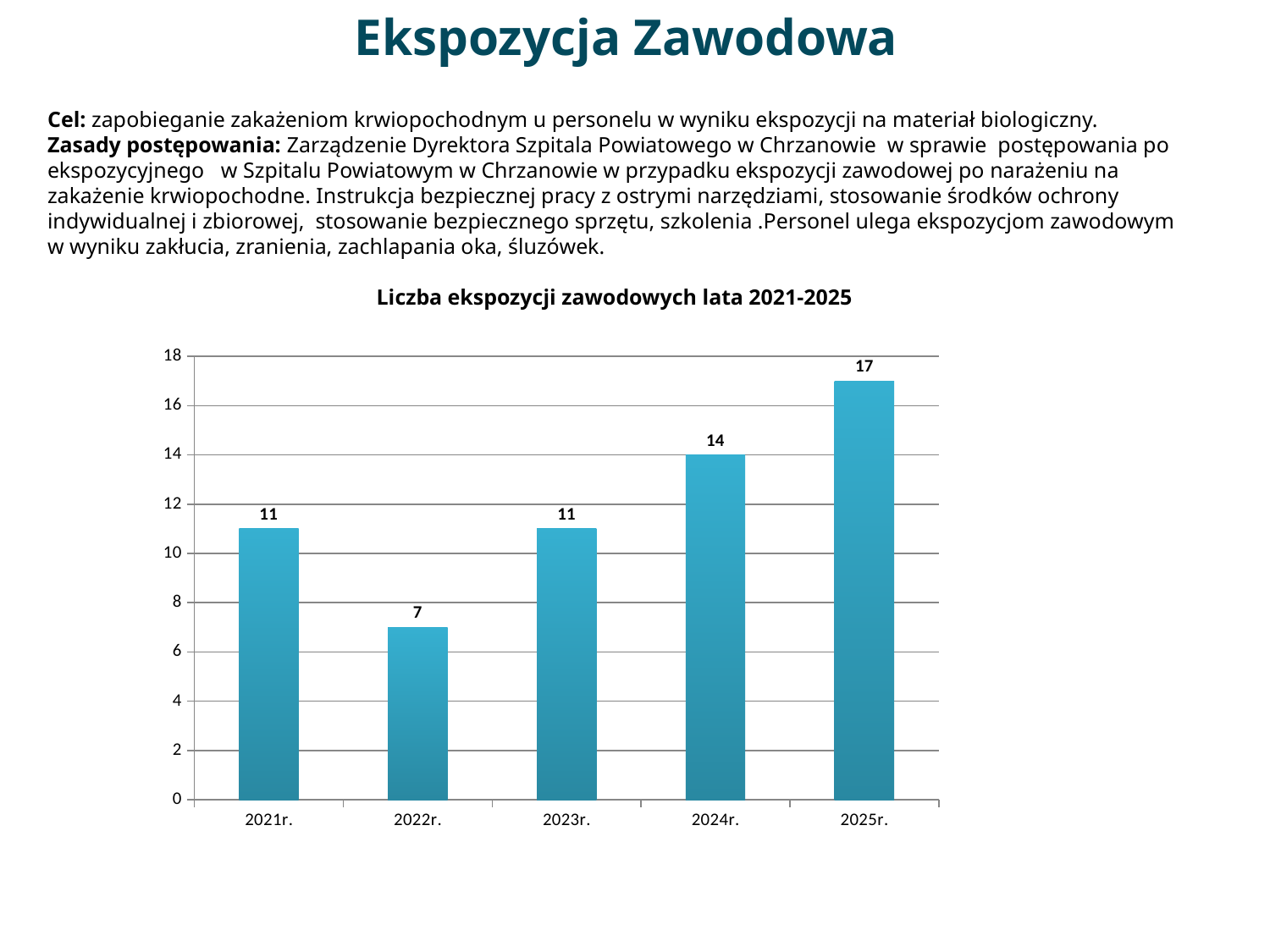
What is the difference between the values for 2024r. and 2023r.? 3 Which year has the highest value? 2025r. What is the value for 2024r.? 14 What is the value for 2022r.? 7 Which is larger, the value for 2021r. or the value for 2024r.? 2024r. What is the value for 2025r.? 17 How many years are shown on the chart? 5 What is the difference between the values for 2025r. and 2022r.? 10 What is the title of the chart? Liczba ekspozycji zawodowych lata 2021-2025 What is the value for 2021r.? 11 What kind of chart is shown on the slide? bar chart Which year has the lowest value? 2022r.